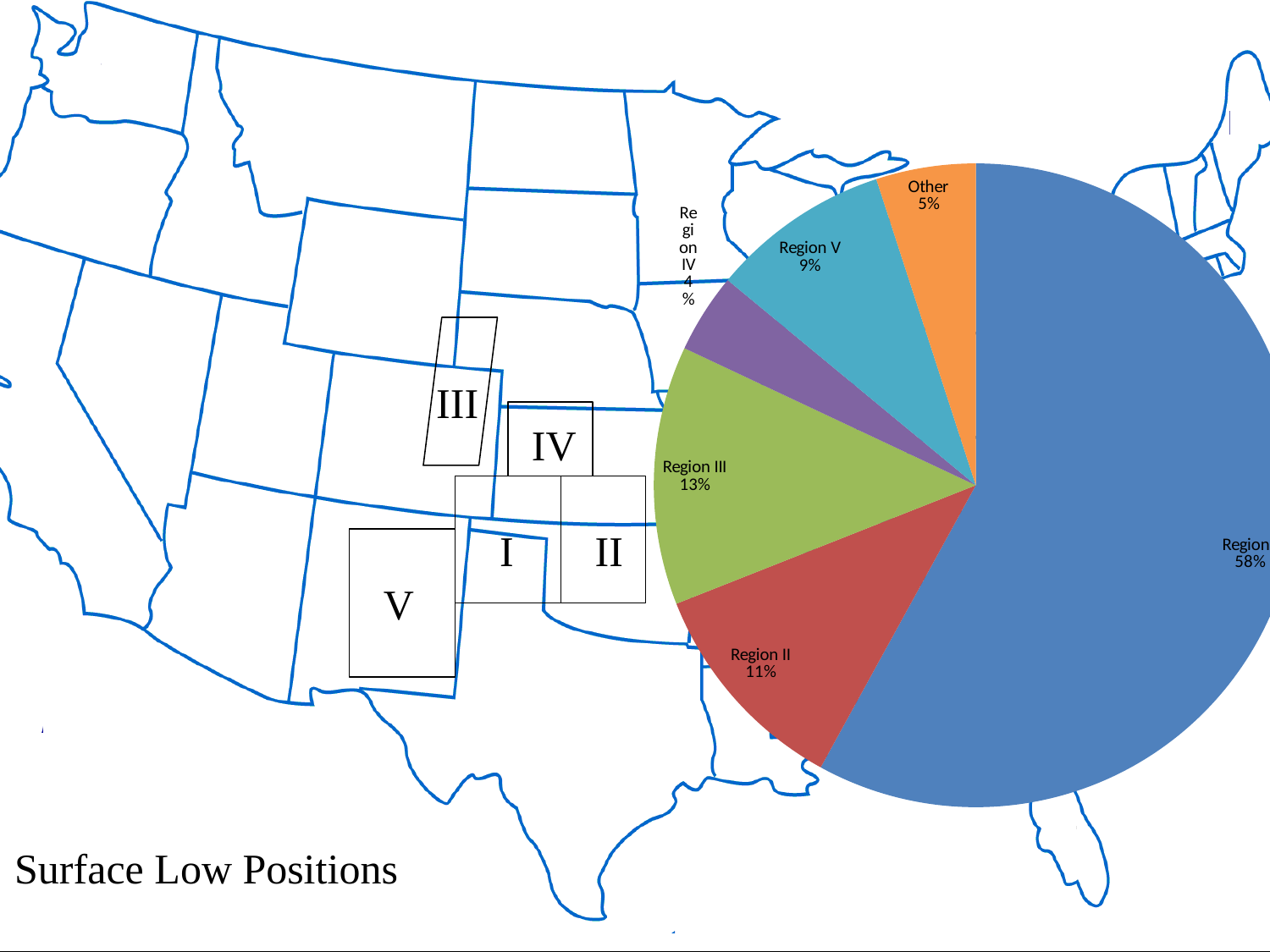
What percentage is shown for the largest slice of the pie? 58% Which slice of the pie has the smallest share? Region IV What share of the pie does the Other slice have? 5% What kind of chart is shown on the slide? pie chart What share of the pie does Region III have? 13% Which has the larger share, Region V or Other? Region V What share of the pie does Region II have? 11% How many slices does the pie chart have? 6 What is the title text shown at the bottom left of the slide? Surface Low Positions What is the difference between the shares of Region III and Region II? 2%